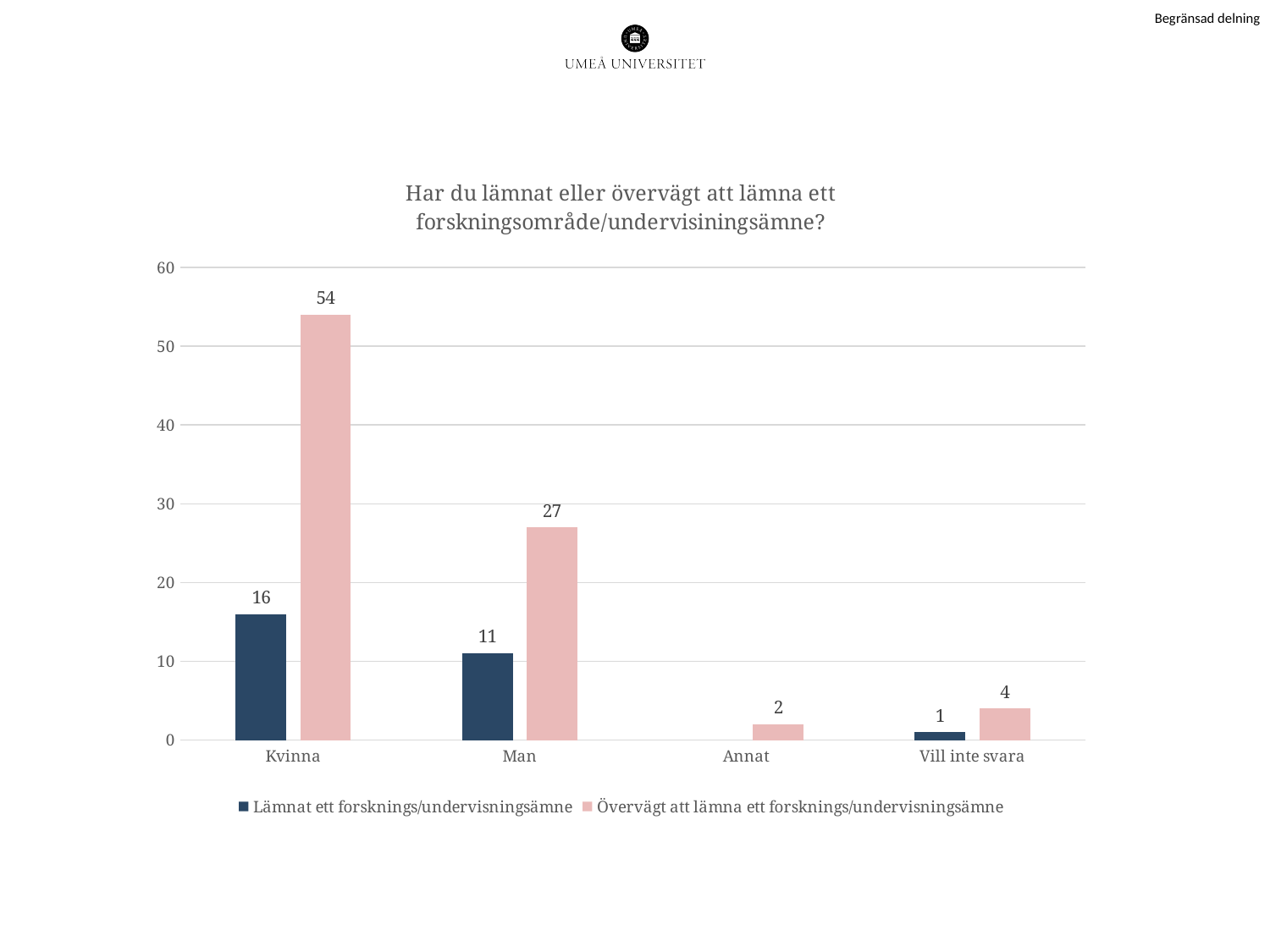
Which category has the highest value in the 'Övervägt att lämna ett forsknings/undervisningsämne' series? Kvinna How many categories are shown on the x axis? 4 How many series does the legend list? 2 Which category has the lowest value in the 'Lämnat ett forsknings/undervisningsämne' series among those with a labelled bar? Vill inte svara What kind of chart is shown on the slide? Bar chart What is the value for Vill inte svara in the 'Övervägt att lämna ett forsknings/undervisningsämne' series? 4 What is the value for Man in the 'Lämnat ett forsknings/undervisningsämne' series? 11 What is the difference between the 'Övervägt att lämna' values for Kvinna and Man? 27 Which is larger: the 'Lämnat ett forsknings/undervisningsämne' value for Kvinna or for Man? Kvinna Is the 'Övervägt att lämna' value for Man greater or less than 30? less What is the difference between the 'Övervägt att lämna' and 'Lämnat' values for Kvinna? 38 What is the value for Kvinna in the 'Övervägt att lämna ett forsknings/undervisningsämne' series? 54